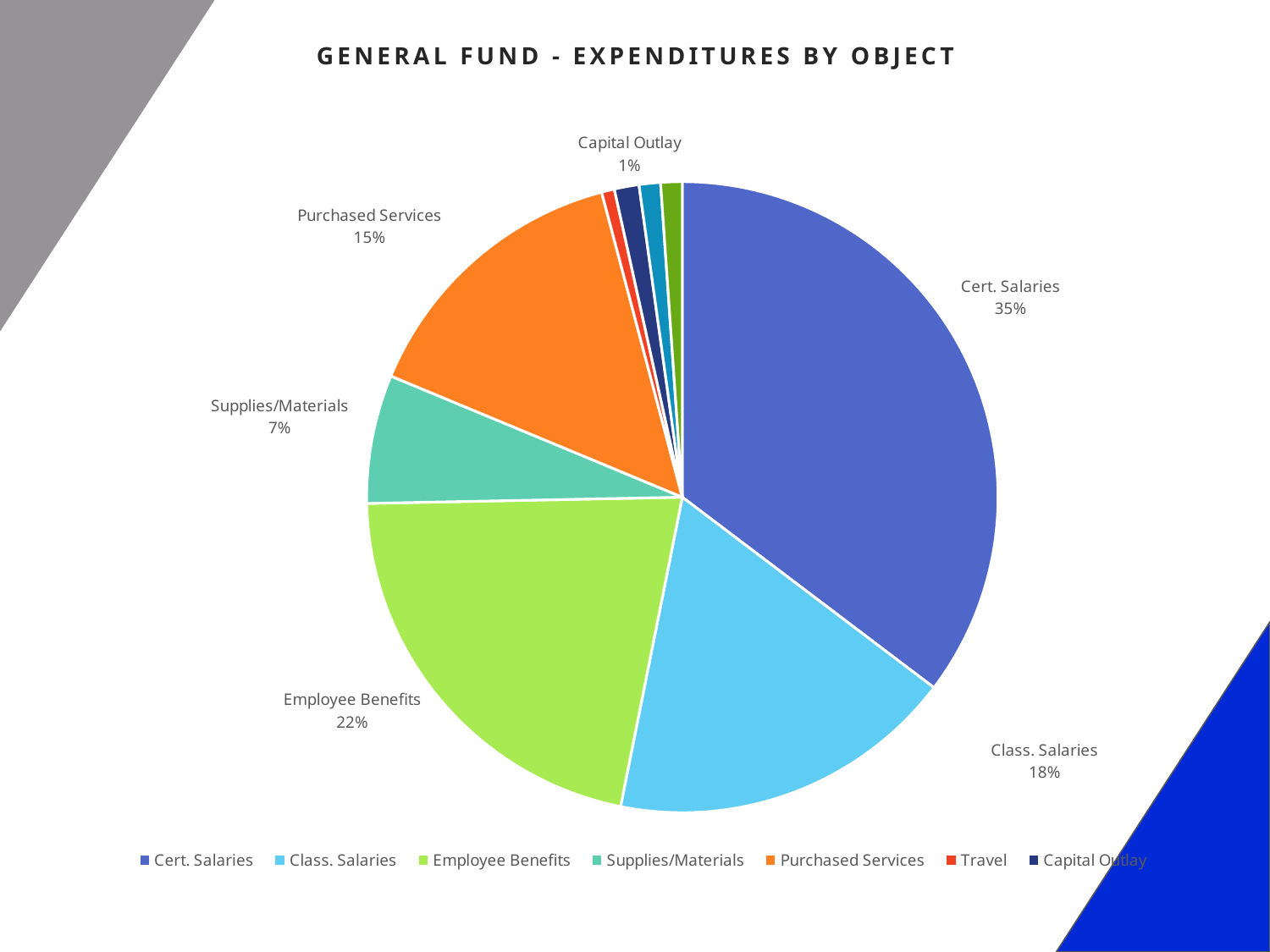
What is the difference in percentage points between Cert. Salaries and Purchased Services? 20 What share of the pie is Employee Benefits? 22% What share of the pie is Class. Salaries? 18% How many entries does the legend list? 7 Which category has the largest slice of the pie? Cert. Salaries Which is larger, Employee Benefits or Class. Salaries? Employee Benefits What kind of chart is shown on the slide? pie chart What share of the pie is Cert. Salaries? 35% What is the title of the chart? GENERAL FUND - EXPENDITURES BY OBJECT